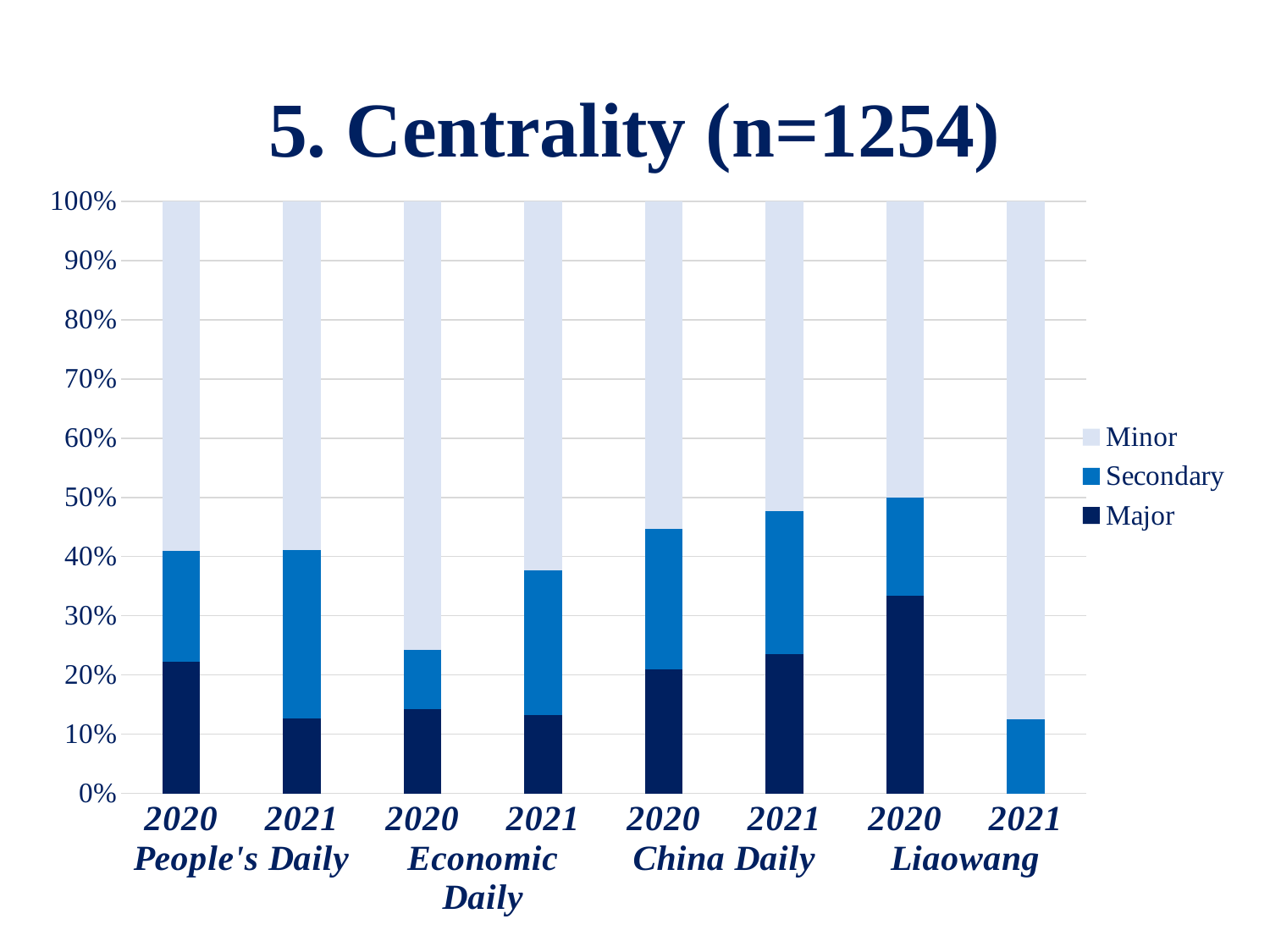
Which bar has no visible Major segment at all? Liaowang 2021 How many bars are plotted in the chart? 8 Which has the larger Major share, Liaowang 2020 or China Daily 2020? Liaowang 2020 Is the combined Major and Secondary share for Economic Daily 2020 greater or less than 30%? less Is the Major share for Liaowang 2020 greater or less than 30%? greater What kind of chart is shown on the slide? Stacked bar chart What is the title of the chart? 5. Centrality (n=1254) Which series is shown in the darkest blue at the bottom of each bar? Major Is the Major share for People's Daily 2021 greater or less than 20%? less Which bar has the largest Major share? Liaowang 2020 How many series does the legend list? 3 Which has the larger Major share, People's Daily 2020 or People's Daily 2021? People's Daily 2020